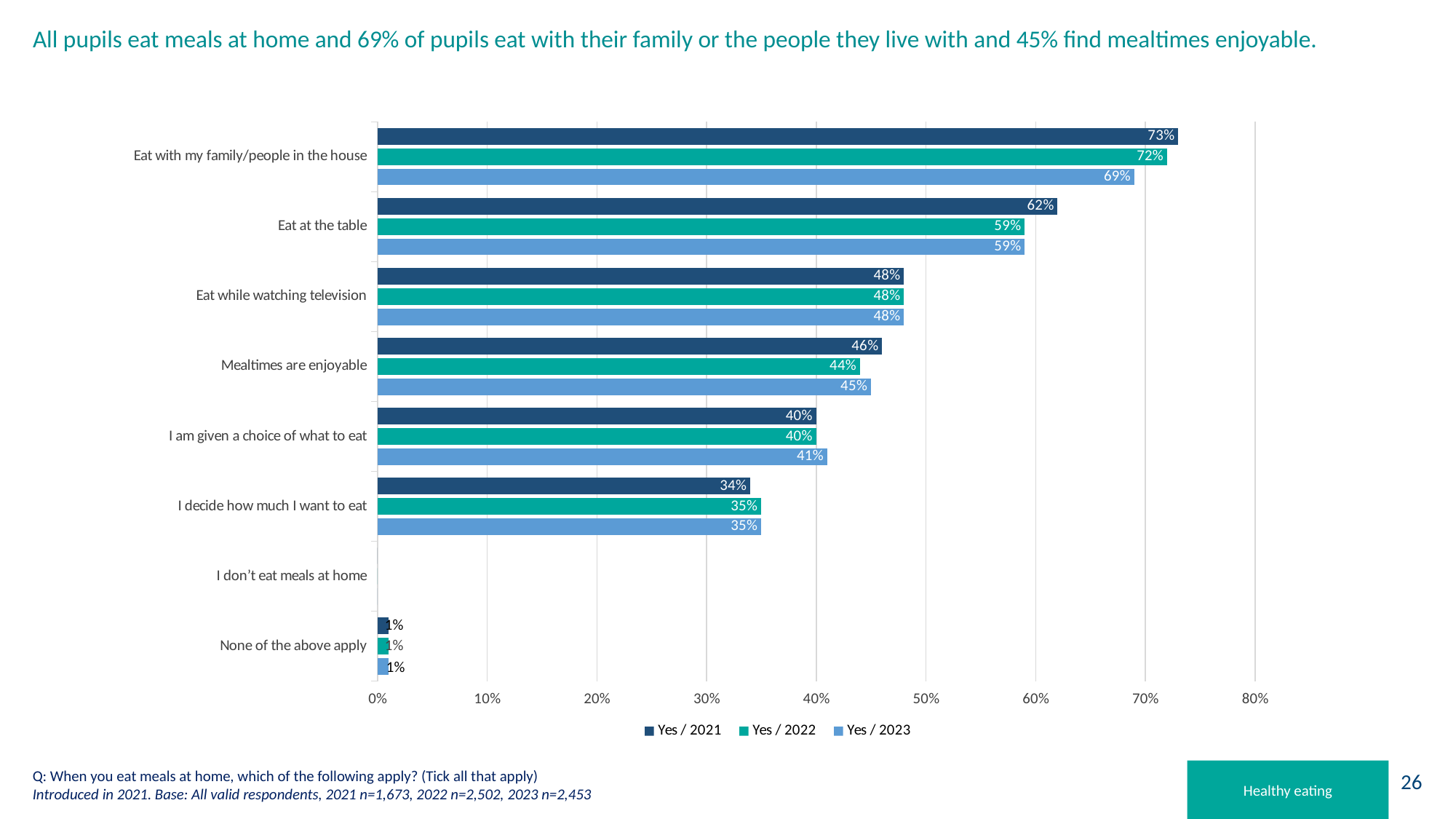
What is the value for 'Eat at the table' in the Yes / 2021 series? 62% Which is larger for 'I decide how much I want to eat': the Yes / 2021 value or the Yes / 2022 value? Yes / 2022 How many series does the legend list? 3 Which category with a plotted bar has the lowest value in the Yes / 2023 series? None of the above apply What is the value for 'Mealtimes are enjoyable' in the Yes / 2022 series? 44% Which legend entry is shown in the darkest colour? Yes / 2021 How many categories are listed on the vertical axis of the chart? 8 What is the value for 'Eat with my family/people in the house' in the Yes / 2023 series? 69% What kind of chart is shown on the slide? Bar chart Which category has the highest value in the Yes / 2021 series? Eat with my family/people in the house What is the difference between the Yes / 2021 and Yes / 2023 values for 'Eat with my family/people in the house'? 4 percentage points Is the Yes / 2022 value for 'Eat at the table' greater or less than 50%? greater